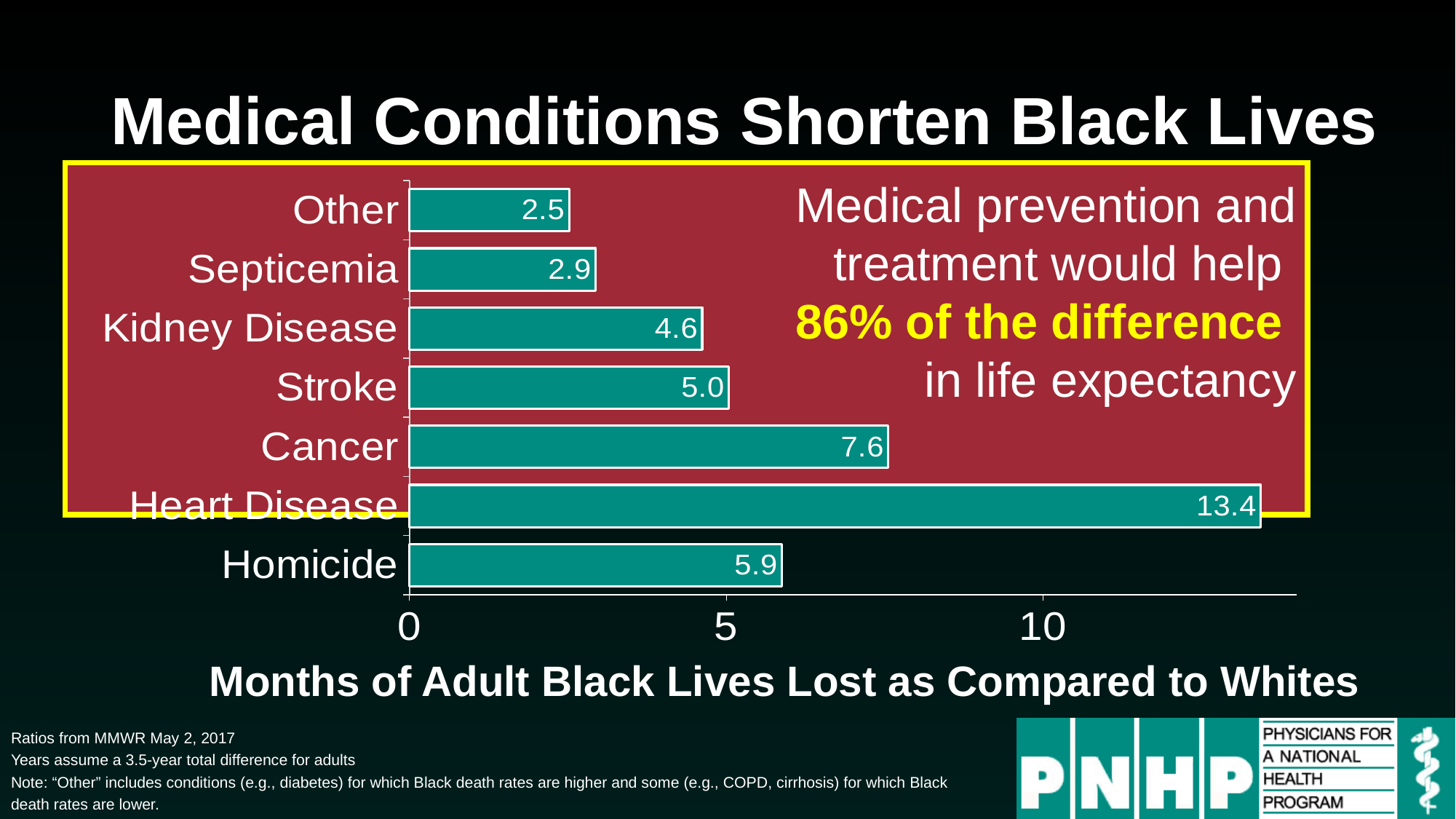
Which category has the lowest value? Other What kind of chart is shown on the slide? Bar chart How many categories are shown in the chart? 7 What is the value for Homicide? 5.9 What is the value for Septicemia? 2.9 Which category has the highest value? Heart Disease Which is larger, the value for Homicide or the value for Stroke? Homicide What is the value for Kidney Disease? 4.6 What is the difference between the values for Heart Disease and Cancer? 5.8 What is the difference between the values for Stroke and Other? 2.5 What is the value for Heart Disease? 13.4 What is the x-axis label of the chart? Months of Adult Black Lives Lost as Compared to Whites